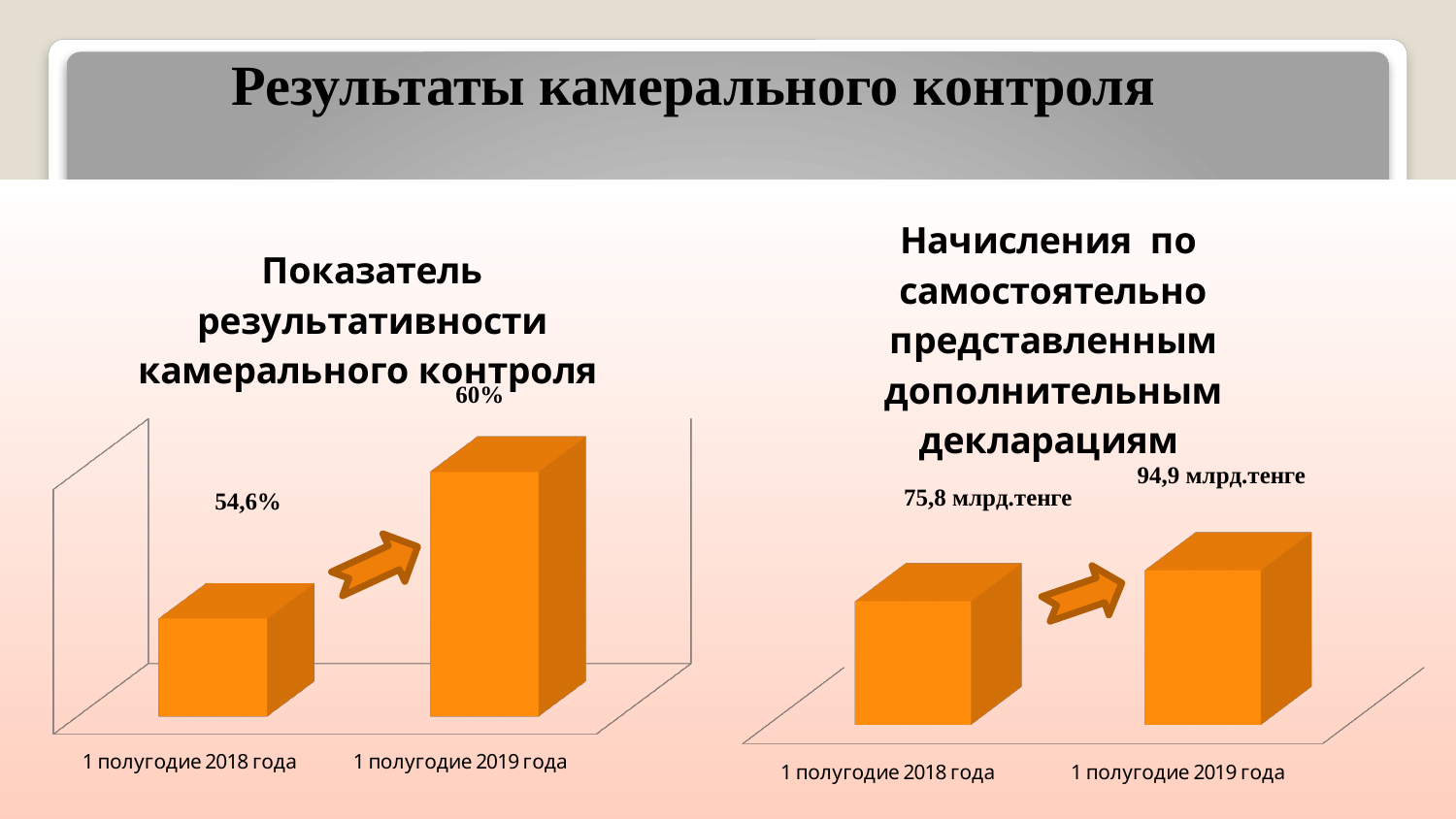
In the right chart, what is the difference between the 2019 and 2018 values? 19,1 млрд.тенге In the left chart, which period has the higher value? 1 полугодие 2019 года In the right chart, which period has the lower value? 1 полугодие 2018 года In the left chart (Показатель результативности камерального контроля), what is the value for 1 полугодие 2018 года? 54,6% What kind of chart is the right chart? Bar chart In the right chart (Начисления по самостоятельно представленным дополнительным декларациям), what is the value for 1 полугодие 2019 года? 94,9 млрд.тенге In the left chart, do the values rise or fall from 2018 to 2019? Rise In the right chart, which is larger: the value for 1 полугодие 2018 года or 1 полугодие 2019 года? 1 полугодие 2019 года In the left chart (Показатель результативности камерального контроля), what is the value for 1 полугодие 2019 года? 60% In the right chart (Начисления по самостоятельно представленным дополнительным декларациям), what is the value for 1 полугодие 2018 года? 75,8 млрд.тенге In the left chart, what is the difference between the 2019 and 2018 values? 5,4% How many categories are shown in the left chart? 2